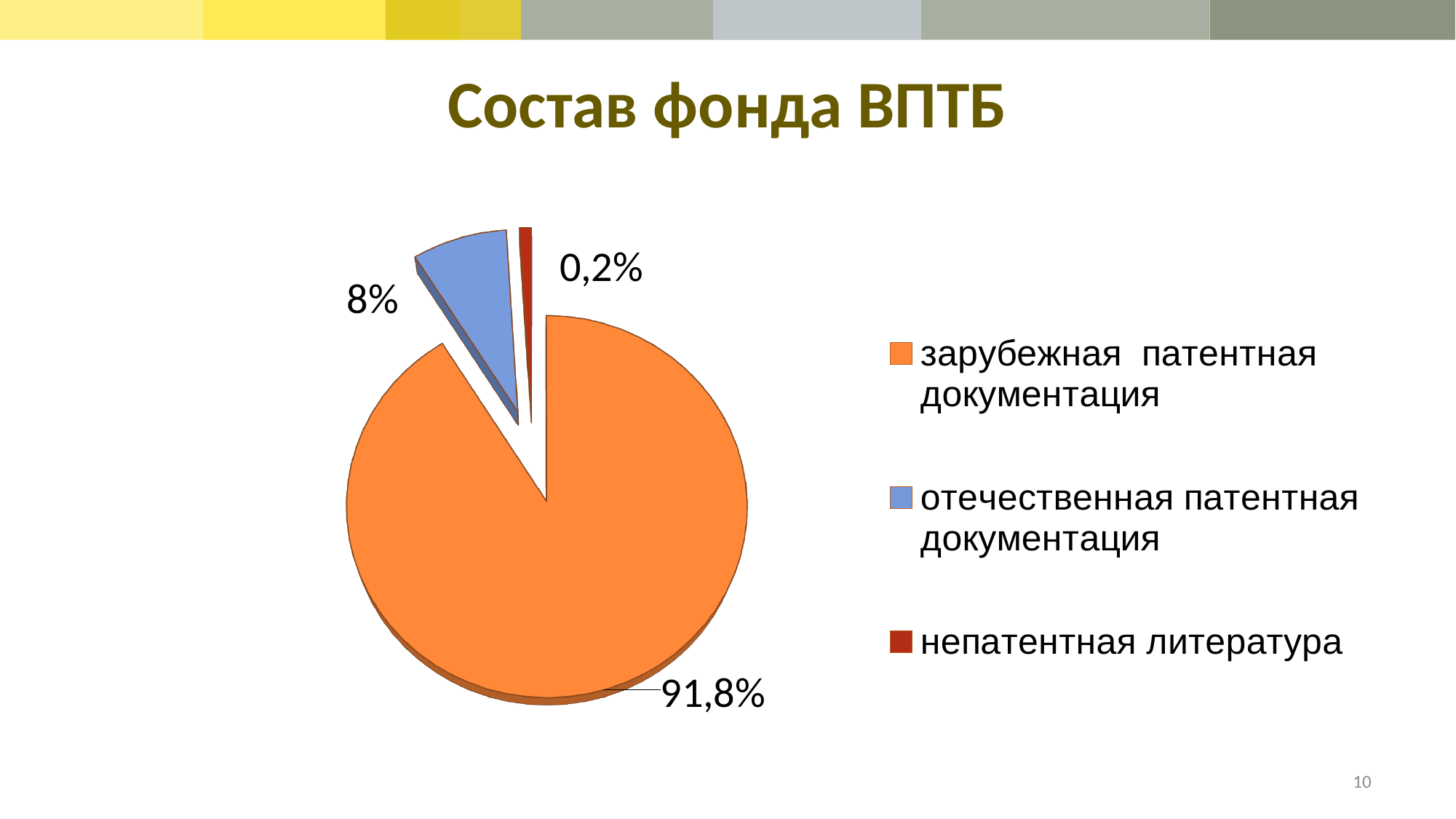
Which category has the largest slice of the pie? зарубежная патентная документация What share of the pie does непатентная литература have? 0,2% What is the difference in percentage points between зарубежная патентная документация and отечественная патентная документация? 83,8 How many entries does the legend list? 3 What kind of chart is shown on the slide? pie chart What share of the pie does отечественная патентная документация have? 8% Which is larger: the share for отечественная патентная документация or for непатентная литература? отечественная патентная документация How many categories does the pie chart show? 3 What is the title of the chart? Состав фонда ВПТБ What share of the pie does зарубежная патентная документация have? 91,8% Which category has the smallest slice of the pie? непатентная литература What colour is the slice for непатентная литература? red